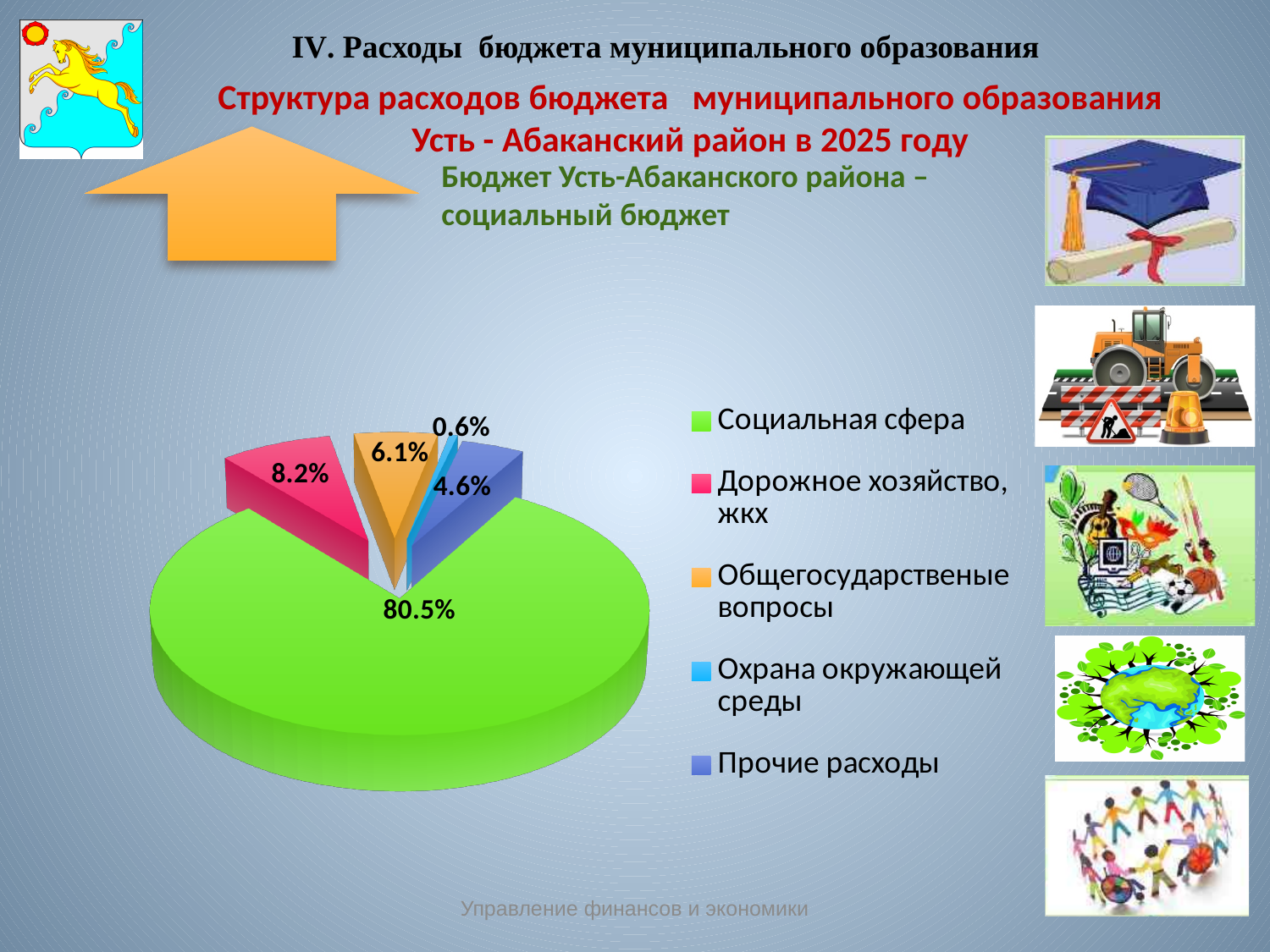
What colour is the slice for Социальная сфера? green Which category has the smallest share of the pie? Охрана окружающей среды How many slices does the pie chart have? 5 What is the value for Прочие расходы? 4.6% Which is larger: Общегосударственые вопросы or Прочие расходы? Общегосударственые вопросы What is the value for Общегосударственые вопросы? 6.1% What is the value for Дорожное хозяйство, жкх? 8.2% What share of the pie does Социальная сфера have? 80.5% What is the difference between the shares of Дорожное хозяйство, жкх and Прочие расходы? 3.6% What is the value for Охрана окружающей среды? 0.6% Which category has the largest share of the pie? Социальная сфера What kind of chart is shown on the slide? pie chart